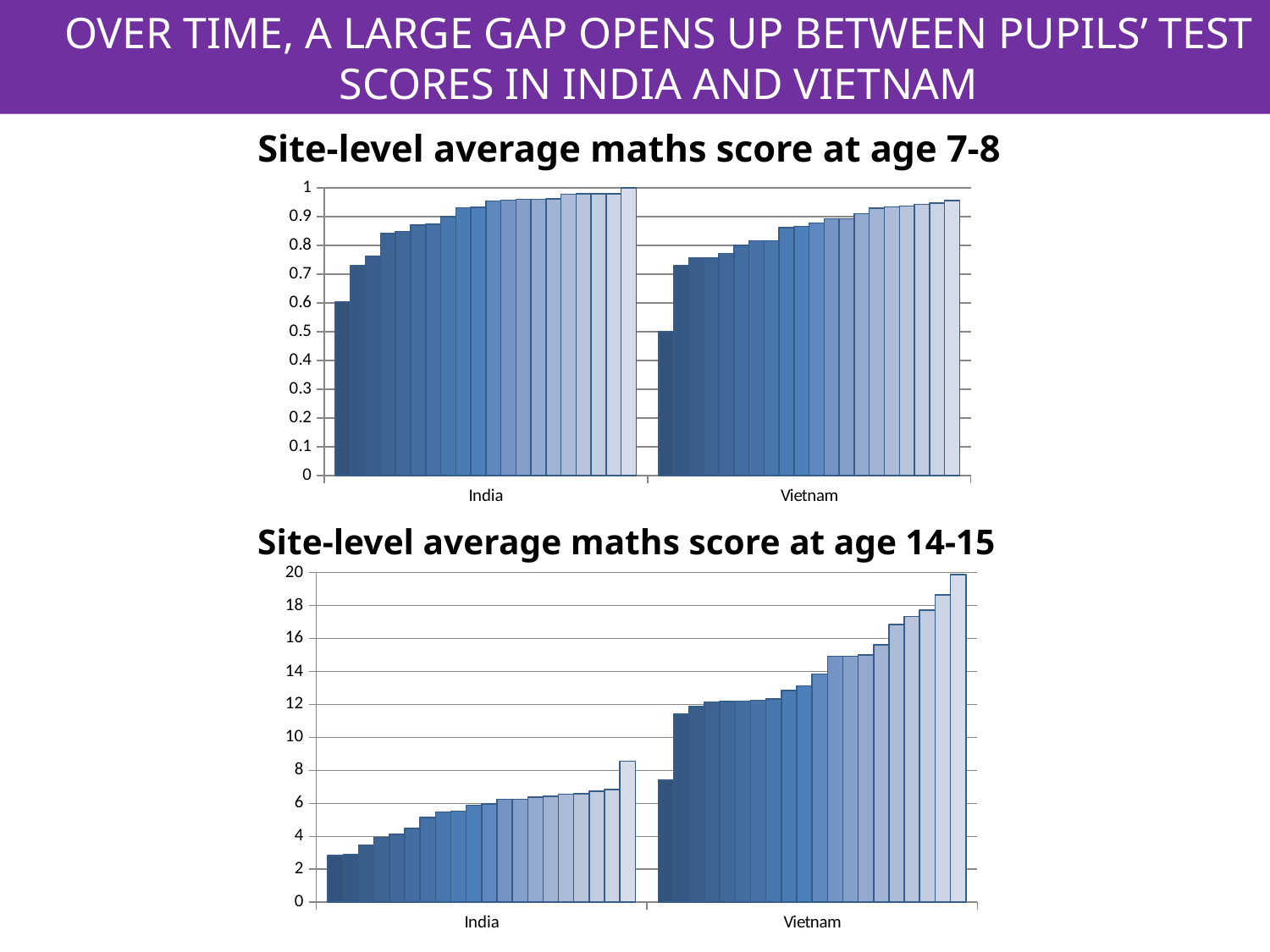
In the 'Site-level average maths score at age 14-15' chart, which country group contains the tallest bar? Vietnam How many country groups are shown on the x axis of the 'Site-level average maths score at age 7-8' chart? 2 In the 'Site-level average maths score at age 14-15' chart, do the bars within the Vietnam group rise or fall from left to right? rise In the 'Site-level average maths score at age 7-8' chart, which country group contains the shortest bar? Vietnam What is the title of the upper chart on the slide? Site-level average maths score at age 7-8 In the 'Site-level average maths score at age 7-8' chart, is the shortest India bar greater or less than 0.5? greater In the 'Site-level average maths score at age 14-15' chart, is the shortest India bar greater or less than 4? less In the 'Site-level average maths score at age 14-15' chart, which is larger: the tallest India bar or the tallest Vietnam bar? the tallest Vietnam bar In the 'Site-level average maths score at age 14-15' chart, is the shortest Vietnam bar greater or less than 6? greater What is the maximum value shown on the y axis of the 'Site-level average maths score at age 14-15' chart? 20 What kind of chart is the 'Site-level average maths score at age 7-8' chart? bar chart